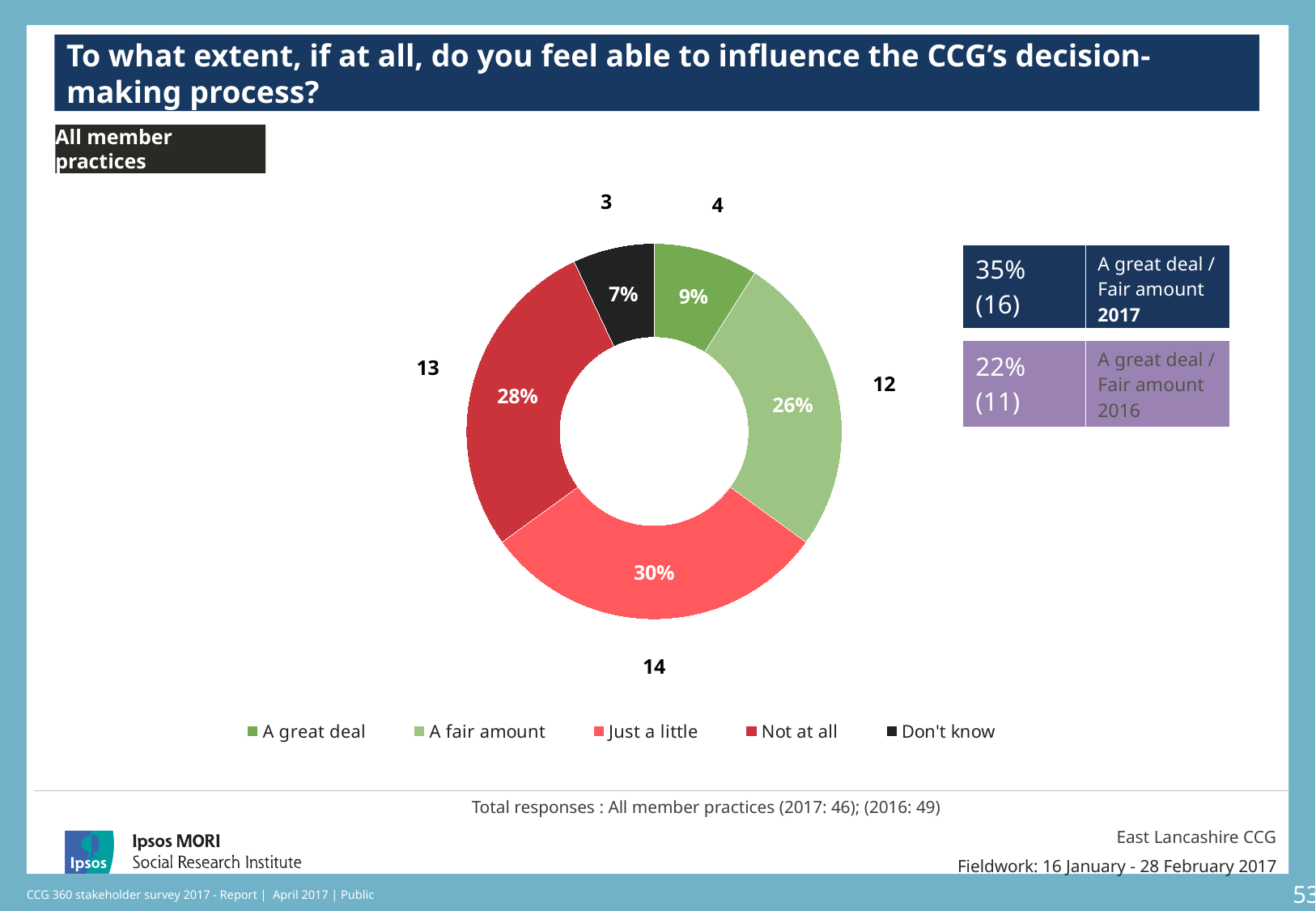
Which response category has the largest share of the chart? Just a little What is the combined percentage for 'A great deal' and 'A fair amount' in 2017, as shown in the box to the right of the chart? 35% Which is larger, the share for 'A fair amount' or the share for 'A great deal'? A fair amount What colour is used for the 'Not at all' slice? Dark red What is the difference in percentage points between 'Not at all' and 'A great deal'? 19 What percentage of respondents said 'Just a little'? 30% What percentage of respondents said 'A fair amount'? 26% What kind of chart is shown on the slide? Doughnut chart How many respondents said 'Not at all', according to the count shown outside the ring? 13 Which response category has the smallest share of the chart? Don't know What percentage of respondents said 'Don't know'? 7% How many response categories are shown in the chart? 5